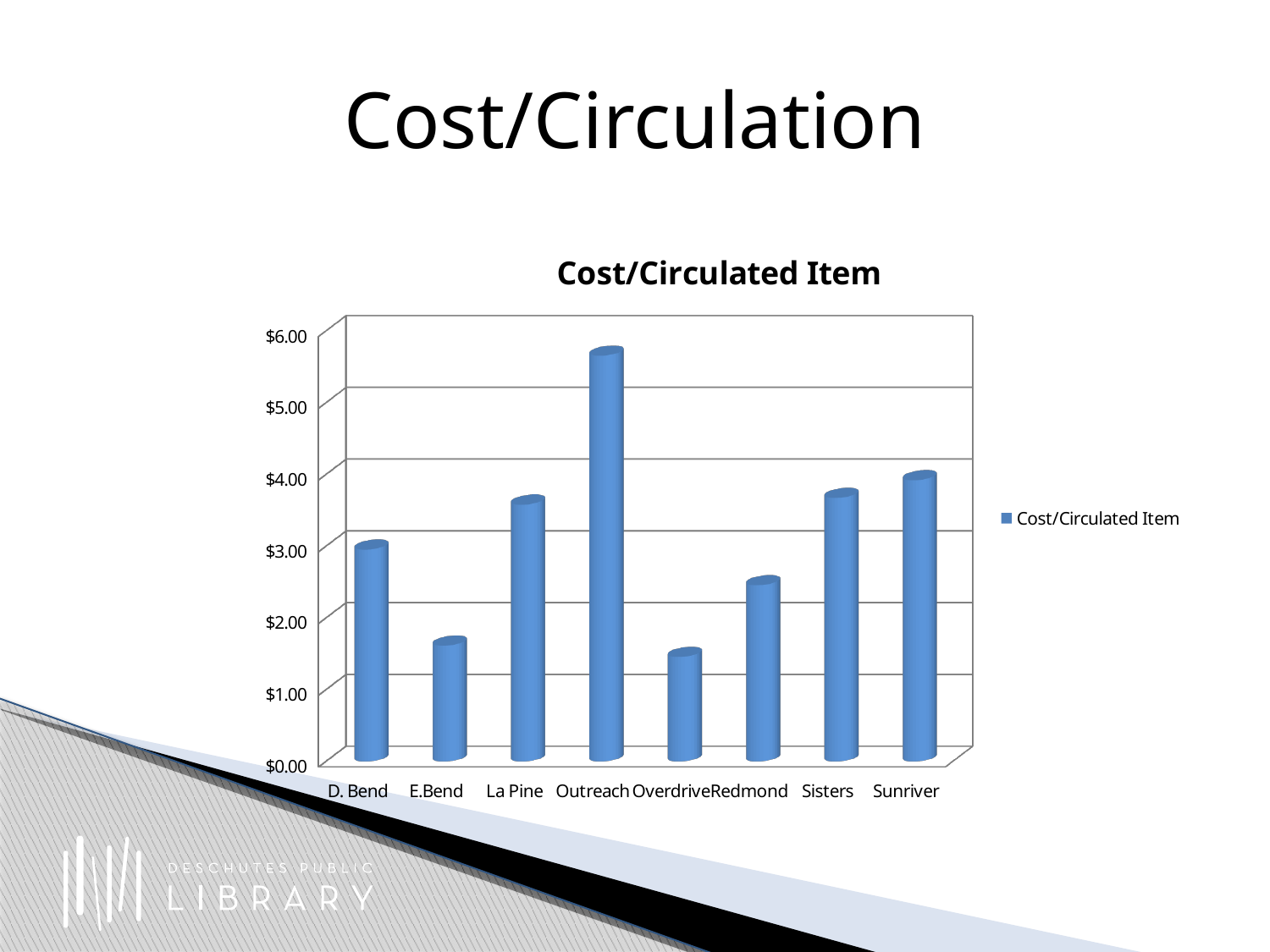
What is the title of the chart? Cost/Circulated Item Which is larger, the value for La Pine or the value for Redmond? La Pine Is the value for E.Bend greater or less than $2.00? less Which is larger, the value for D. Bend or the value for E.Bend? D. Bend Is the value for Sunriver greater or less than $3.00? greater How many series does the chart's legend list? 1 How many categories are shown on the x axis of the chart? 8 Which category has the highest Cost/Circulated Item? Outreach What kind of chart is shown on the slide? bar chart Is the value for Redmond greater or less than $3.00? less